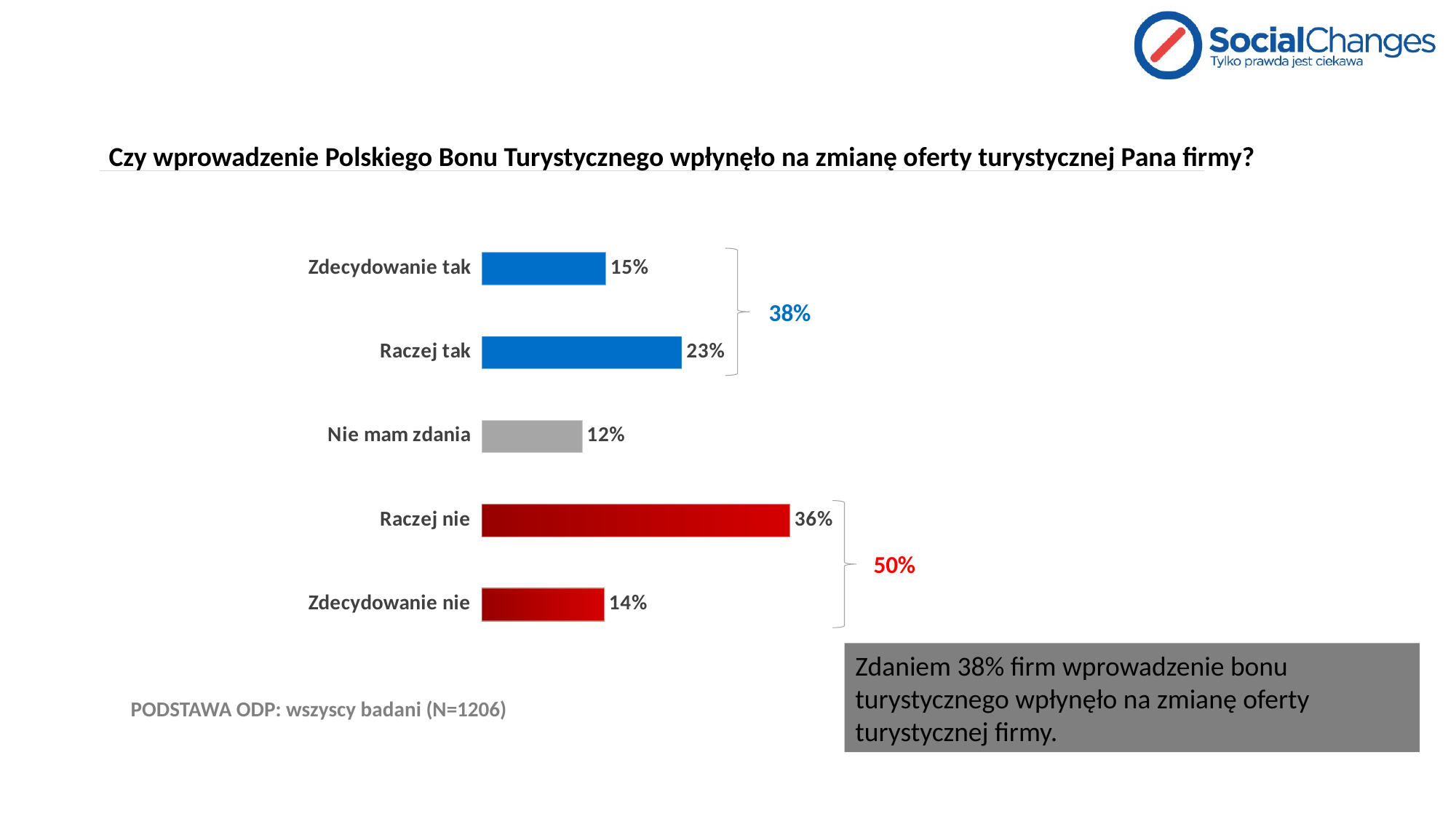
What is the combined value shown for "Raczej nie" and "Zdecydowanie nie"? 50% What is the value for "Nie mam zdania"? 12% Which category has the highest value? Raczej nie What kind of chart is shown on the slide? Bar chart What is the difference between the values for "Raczej nie" and "Raczej tak"? 13% Which category has the lowest value? Nie mam zdania What is the combined value shown for "Zdecydowanie tak" and "Raczej tak"? 38% How many categories are shown in the chart? 5 What is the value for "Zdecydowanie tak"? 15% Which is larger, the value for "Raczej tak" or the value for "Zdecydowanie nie"? Raczej tak What colour are the bars for "Raczej nie" and "Zdecydowanie nie"? Red What is the value for "Raczej nie"? 36%